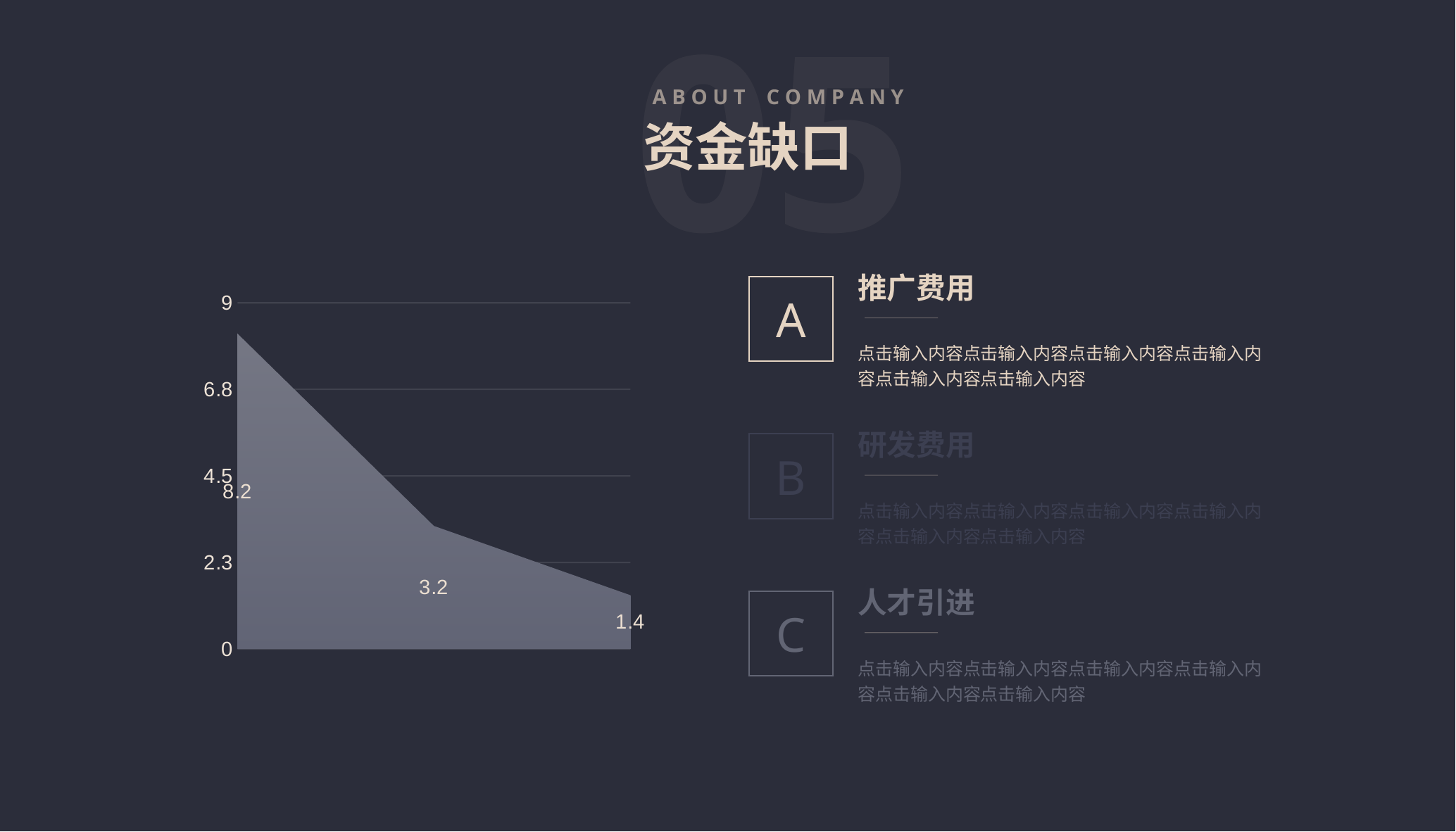
Which is larger, the first data point or the last data point? the first data point Do the values rise or fall from left to right along the chart? fall What is the value of the middle data point in the chart? 3.2 What is the value of the first (leftmost) data point in the chart? 8.2 What kind of chart is shown on the slide? area chart What is the value of the last (rightmost) data point in the chart? 1.4 How many data points are plotted in the chart? 3 What is the highest tick value shown on the chart's vertical axis? 9 What is the difference between the first data point (8.2) and the middle data point (3.2)? 5 What is the difference between the middle data point (3.2) and the last data point (1.4)? 1.8 What is the highest value plotted in the chart? 8.2 What is the lowest value plotted in the chart? 1.4